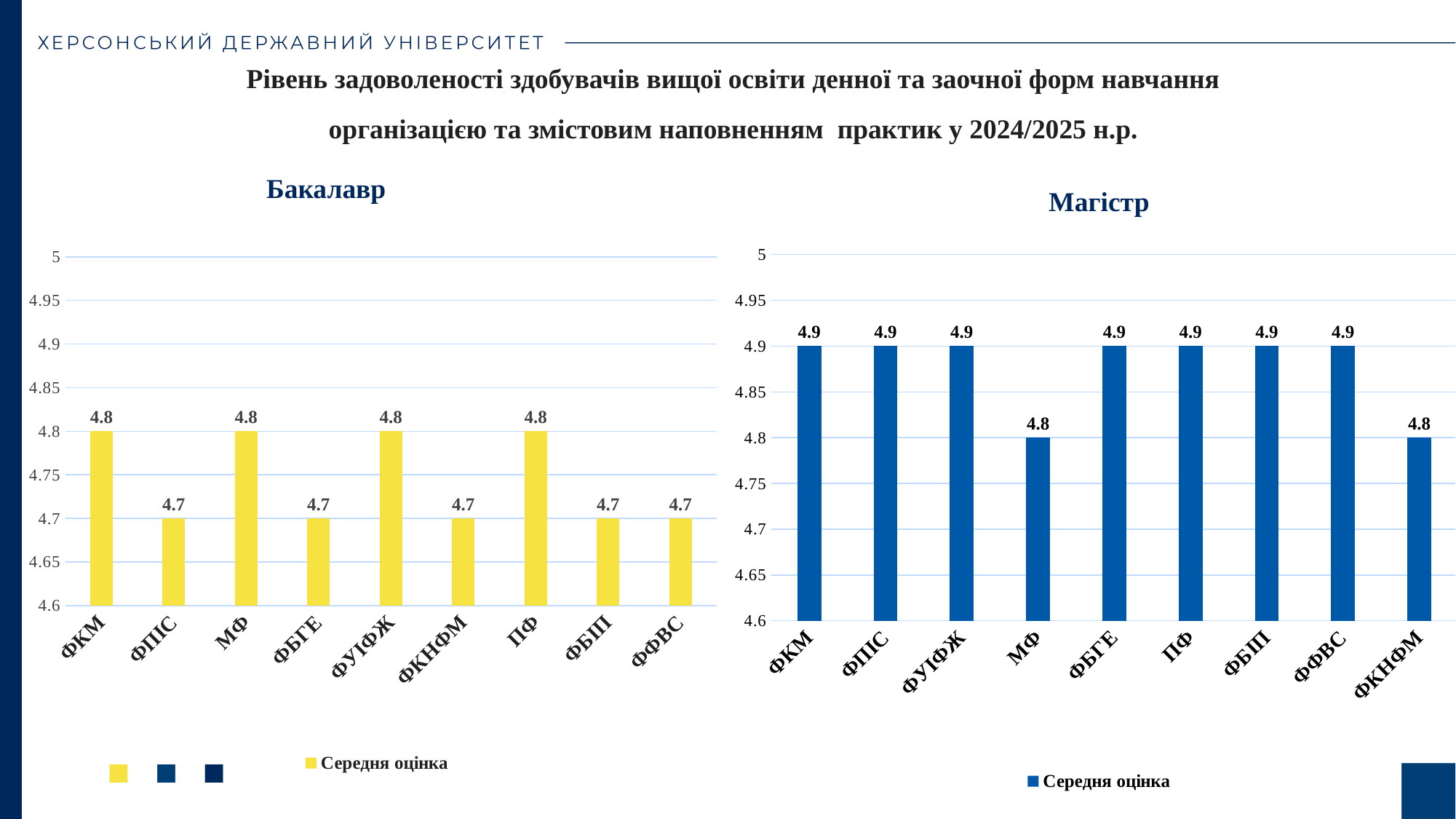
What kind of chart is the Магістр chart? bar chart How many categories are shown in the Магістр chart? 9 How many series does the legend of the Бакалавр chart list? 1 In the Магістр chart, what is the value for ФФВС? 4.9 In the Бакалавр chart, what is the value for ФКНФМ? 4.7 In the Бакалавр chart, what is the value for ФКМ? 4.8 In the Бакалавр chart, which is larger, the value for ПФ or the value for ФБП? ПФ In the Магістр chart, which is larger, the value for ФБГЕ or the value for МФ? ФБГЕ In the Бакалавр chart, what is the difference between the values for МФ and ФБГЕ? 0.1 In the Магістр chart, what is the difference between the values for ФКМ and ФКНФМ? 0.1 In the Магістр chart, what is the value for МФ? 4.8 How many categories are shown in the Бакалавр chart? 9